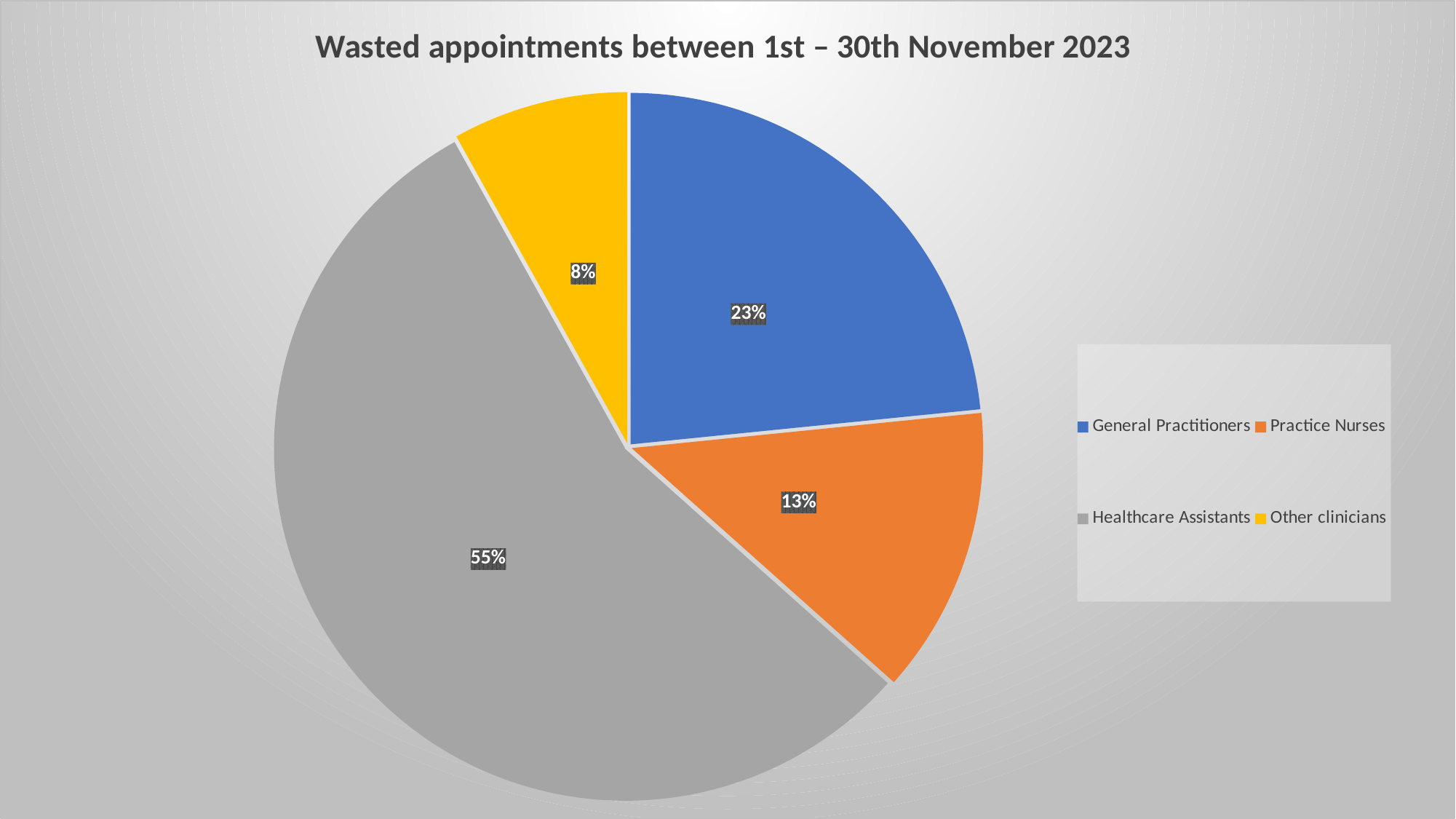
What share of wasted appointments is attributed to General Practitioners? 23% Which category has the smallest share of wasted appointments? Other clinicians What share of wasted appointments is attributed to Practice Nurses? 13% What is the difference in percentage points between the Healthcare Assistants share and the General Practitioners share? 32 What share of wasted appointments is attributed to Healthcare Assistants? 55% How many categories are shown in the pie chart? 4 Which category has the largest share of wasted appointments? Healthcare Assistants What is the title of the chart? Wasted appointments between 1st – 30th November 2023 Which colour represents Healthcare Assistants in the chart? grey What type of chart is shown on the slide? pie chart Which has a larger share of wasted appointments, Practice Nurses or Other clinicians? Practice Nurses